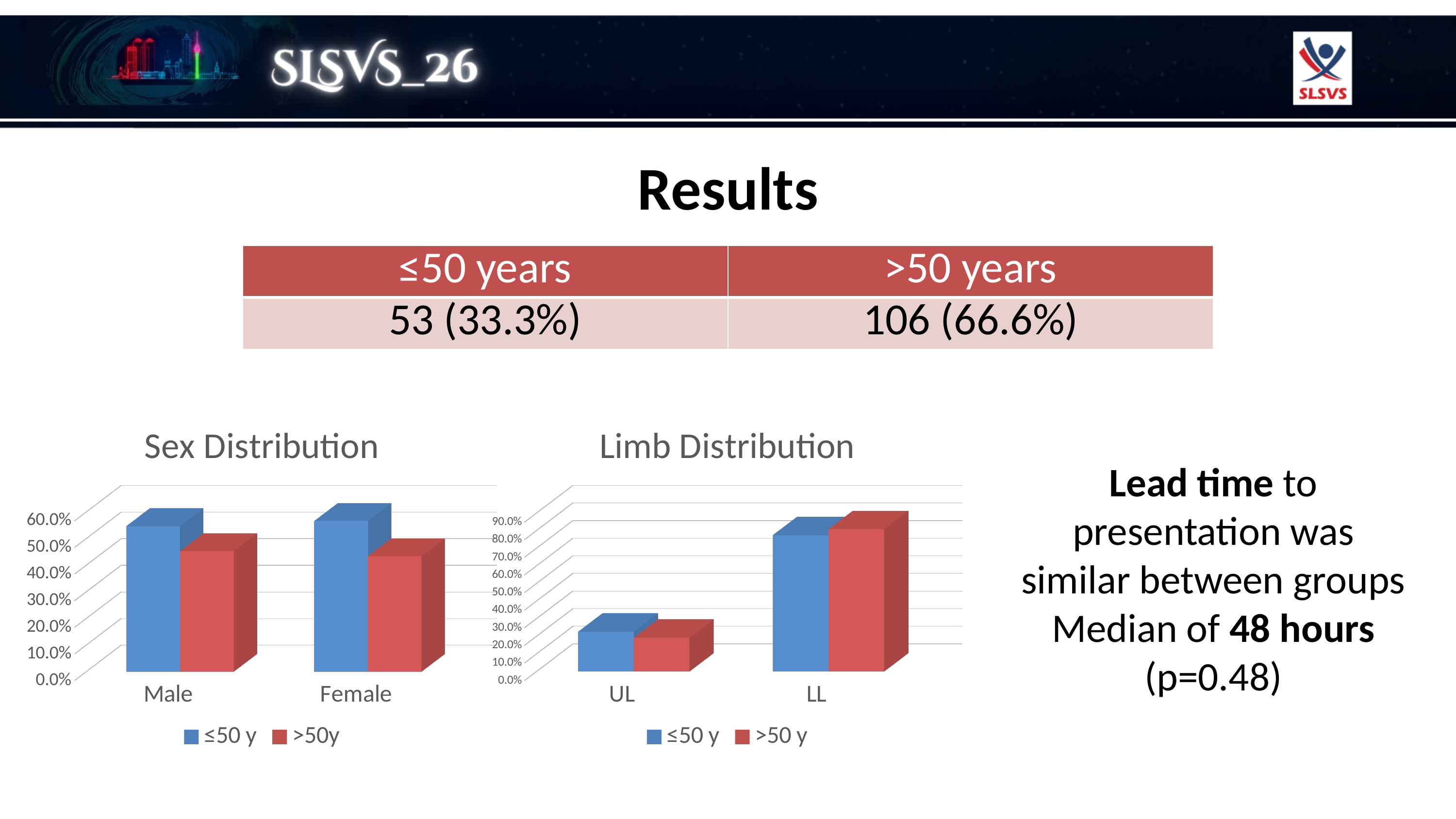
How many categories are shown on the x axis of the Limb Distribution chart? 2 In the Limb Distribution chart, which category has the higher ≤50 y value, UL or LL? LL In the Limb Distribution chart, what colour represents the >50 y series? red In the Sex Distribution chart, is the ≤50 y value for Male greater or less than 40.0%? greater What are the two category labels on the x axis of the Limb Distribution chart? UL and LL In the Sex Distribution chart, which series is larger for Female, ≤50 y or >50y? ≤50 y In the Limb Distribution chart, is the >50 y value for UL greater or less than 50.0%? less How many series does the legend of the Sex Distribution chart list? 2 In the Sex Distribution chart, which series is larger for Male, ≤50 y or >50y? ≤50 y In the Limb Distribution chart, is the ≤50 y value for LL greater or less than 50.0%? greater What kind of chart is the Sex Distribution chart? bar chart